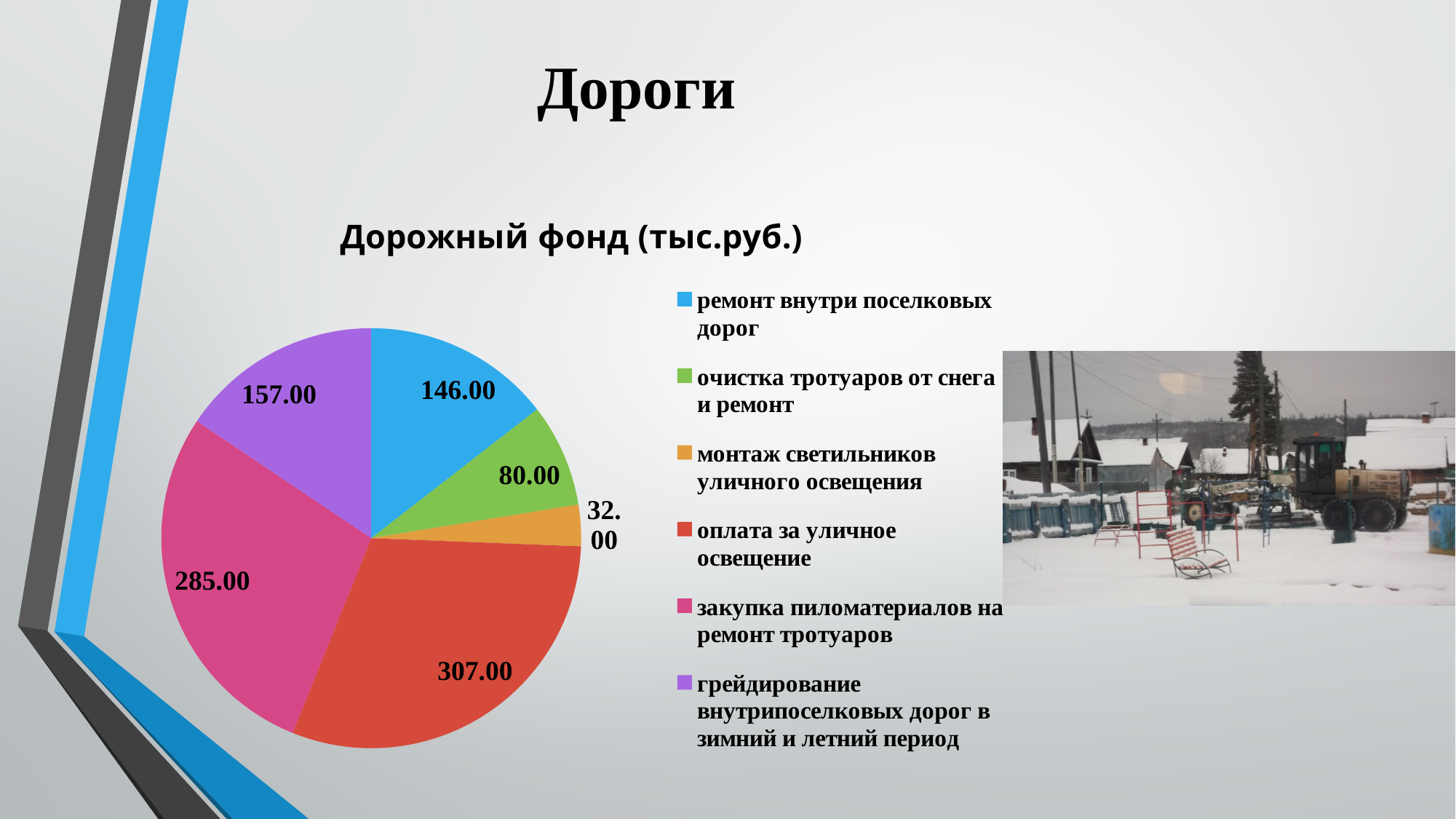
What is the value for 'ремонт внутри поселковых дорог'? 146.00 How many slices does the pie chart have? 6 What type of chart is shown on the slide? pie chart Which category has the smallest value? монтаж светильников уличного освещения Which is larger: 'грейдирование внутрипоселковых дорог в зимний и летний период' or 'очистка тротуаров от снега и ремонт'? грейдирование внутрипоселковых дорог в зимний и летний период What colour is the slice for 'закупка пиломатериалов на ремонт тротуаров'? pink What is the value for 'оплата за уличное освещение'? 307.00 What is the value for 'монтаж светильников уличного освещения'? 32.00 Which category has the largest value? оплата за уличное освещение How many entries does the legend list? 6 What is the difference between the values for 'оплата за уличное освещение' and 'закупка пиломатериалов на ремонт тротуаров'? 22.00 What is the title of the chart? Дорожный фонд (тыс.руб.)